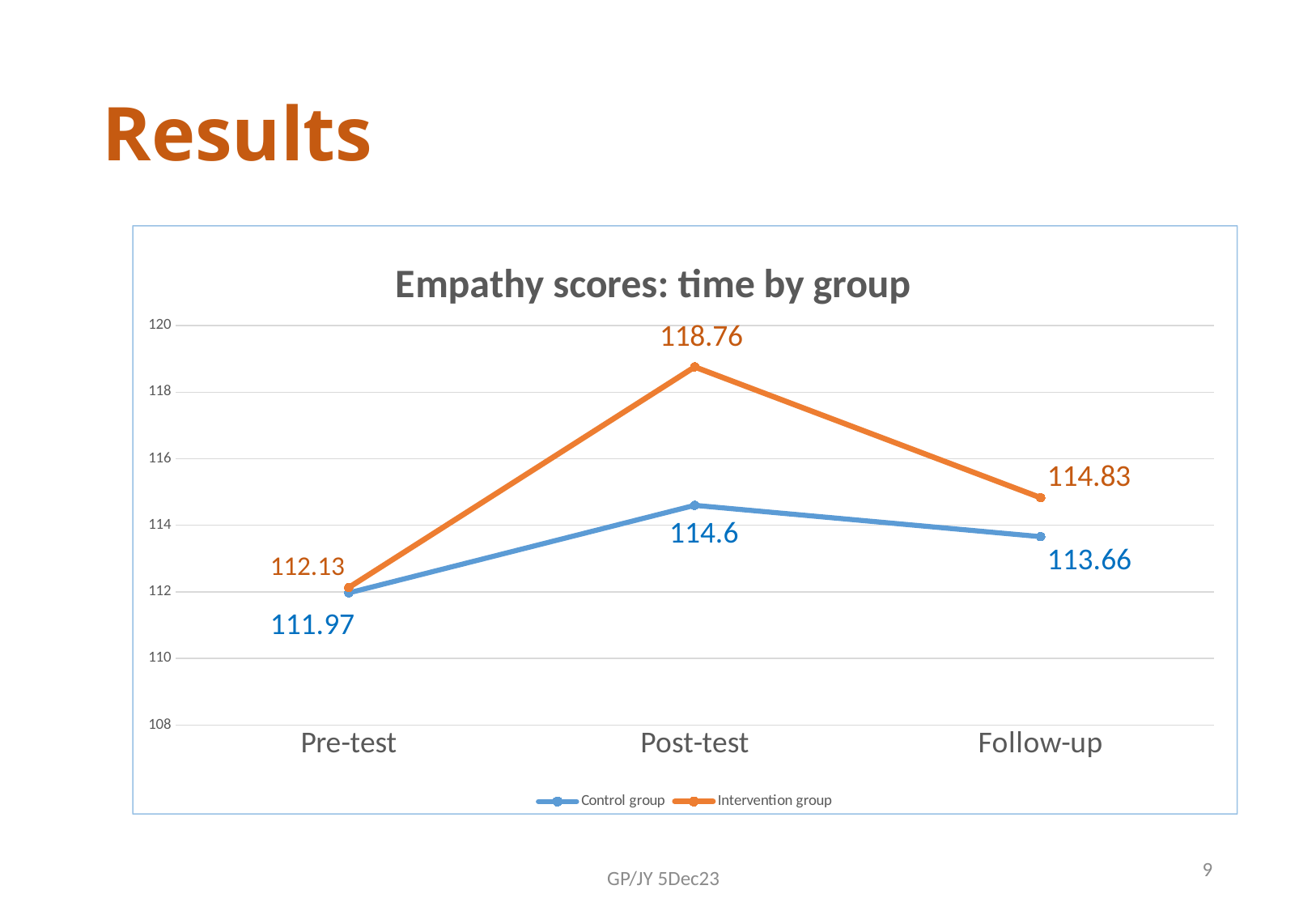
What is the Intervention group's empathy score at Post-test? 118.76 What is the difference between the Intervention group and Control group scores at Post-test? 4.16 Is the Intervention group's Post-test score greater or less than 118? greater What is the Control group's empathy score at Pre-test? 111.97 At which time point is the Control group's score lowest? Pre-test What is the title of the chart? Empathy scores: time by group What kind of chart is shown? Line chart At which time point is the Intervention group's score highest? Post-test How many series does the legend list? 2 Which group has the higher score at Follow-up? Intervention group How many time points are shown on the x axis? 3 What is the Control group's empathy score at Follow-up? 113.66